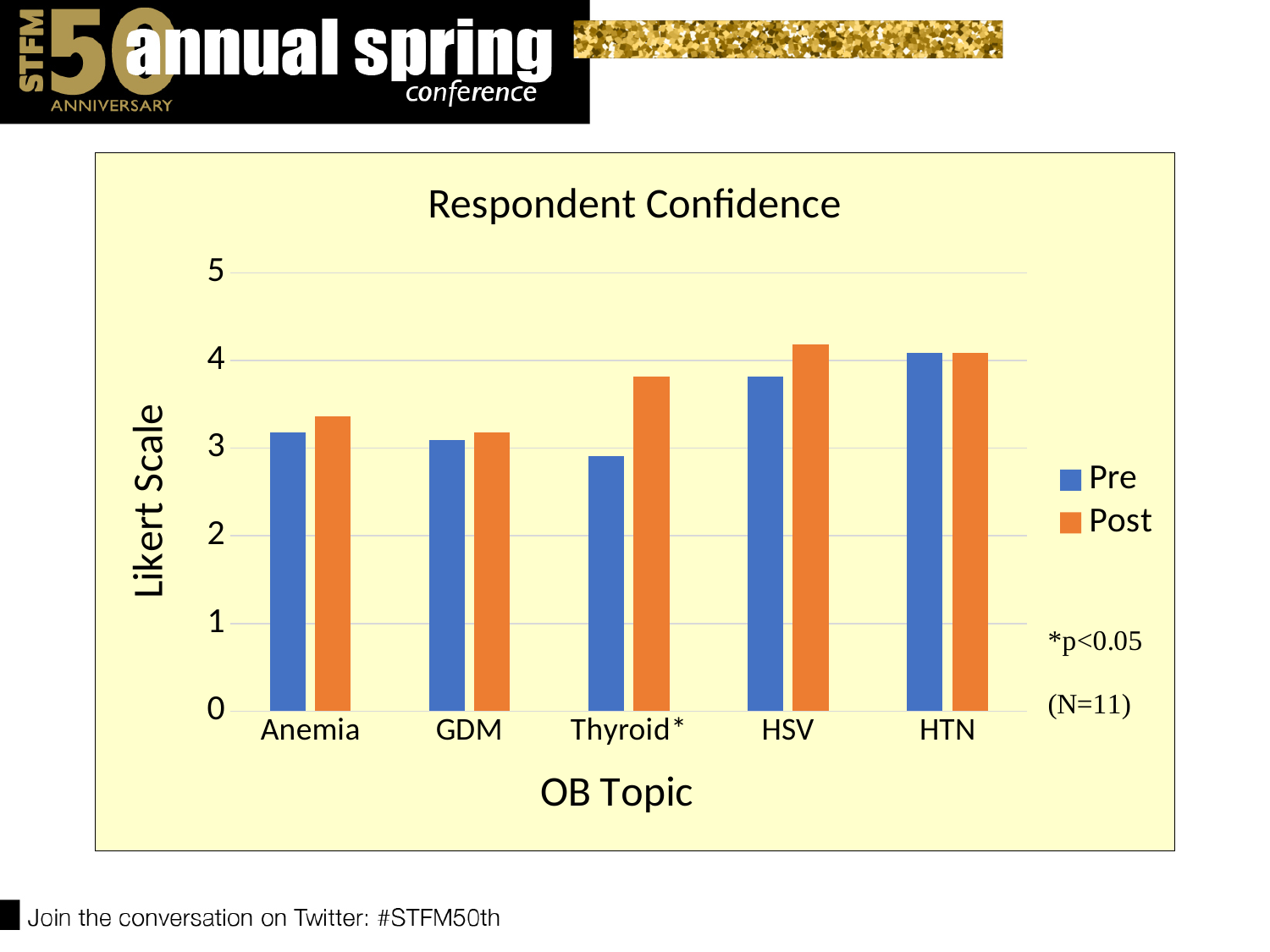
For HSV, which is larger, the Pre value or the Post value? Post Is the Pre value for Thyroid* greater or less than 3? less Which OB topic has the lowest Pre value? Thyroid* Which OB topic has the highest Pre value? HTN Which OB topic has the lowest Post value? GDM What kind of chart is shown on the slide? bar chart How many series does the chart's legend list? 2 Is the Post value for HSV greater or less than 4? greater What is the title of the chart? Respondent Confidence What is the label of the vertical axis? Likert Scale For Thyroid*, which is larger, the Pre value or the Post value? Post How many OB topics are shown on the x axis of the chart? 5